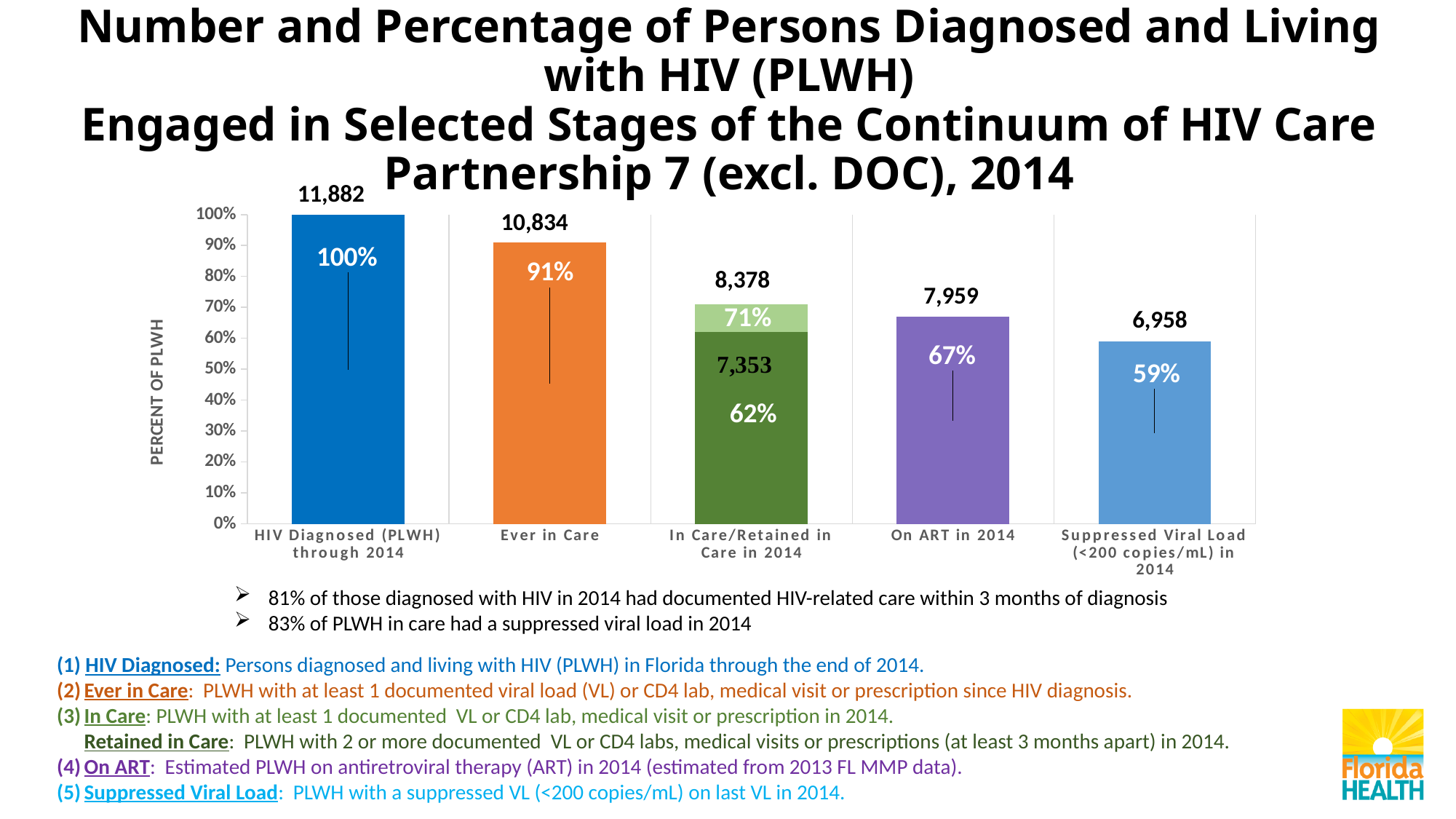
What number is printed above the 'Ever in Care' bar? 10,834 How many categories are shown on the x axis of the chart? 5 What number is printed above the 'Suppressed Viral Load (<200 copies/mL) in 2014' bar? 6,958 What is the difference in number of persons between 'HIV Diagnosed (PLWH) through 2014' and 'Ever in Care'? 1,048 Which category has the highest number of persons? HIV Diagnosed (PLWH) through 2014 What percentage is shown for the 'In Care' (light green) portion of the 'In Care/Retained in Care in 2014' bar? 71% What percentage is shown on the 'On ART in 2014' bar? 67% What number is printed inside the dark green 'Retained in Care' portion of the 'In Care/Retained in Care in 2014' bar? 7,353 Which is larger, the number for 'On ART in 2014' or the number for 'Suppressed Viral Load (<200 copies/mL) in 2014'? On ART in 2014 What kind of chart is shown on the slide? Bar chart Which category has the lowest percentage of PLWH? Suppressed Viral Load (<200 copies/mL) in 2014